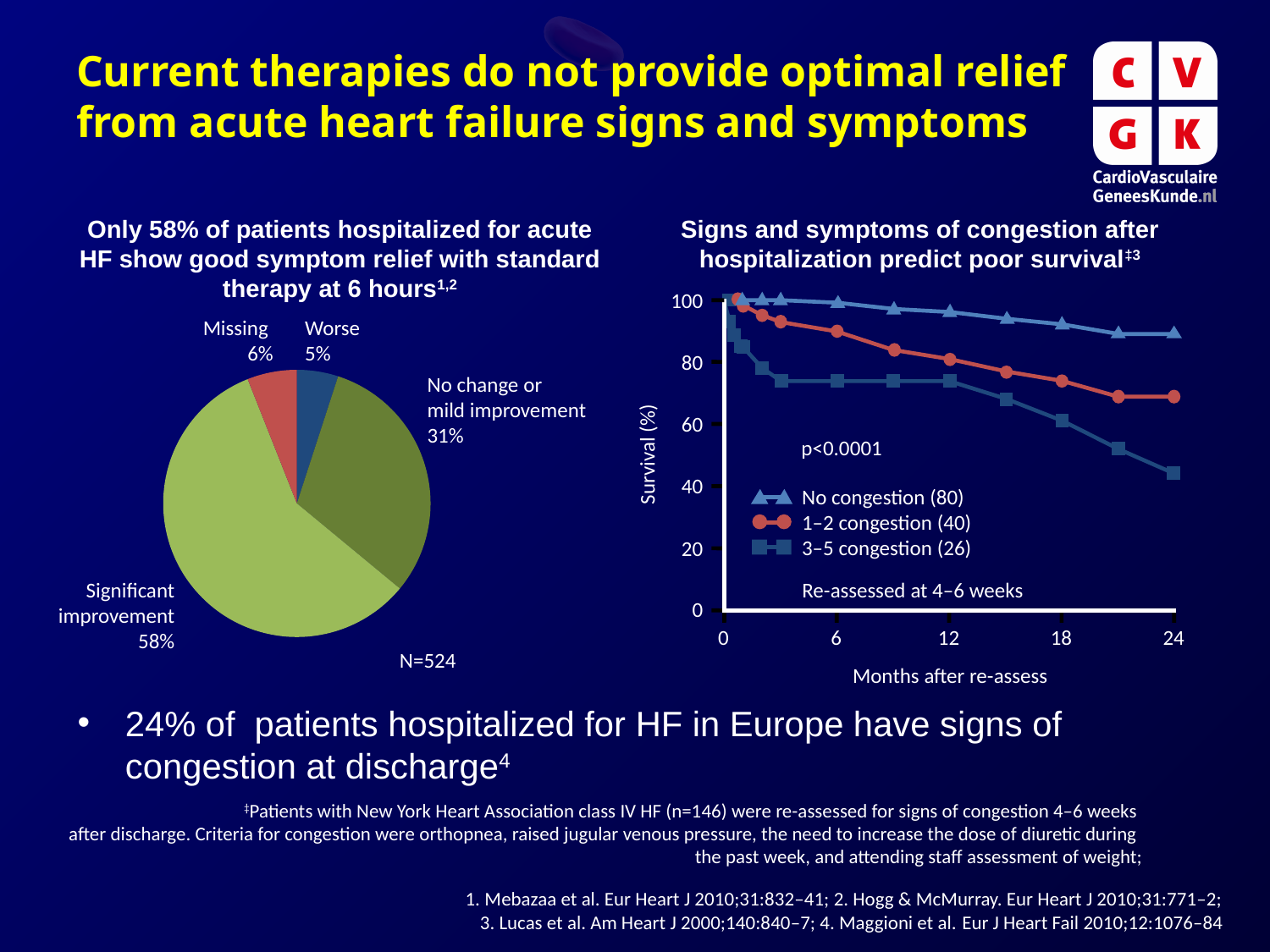
On the pie chart on the left, what is the difference in percentage points between 'Significant improvement' and 'No change or mild improvement'? 27 On the survival chart on the right, is the survival value for the '3–5 congestion (26)' group at 24 months greater or less than 60? less On the pie chart on the left, what share of patients showed significant improvement? 58% On the pie chart on the left, what share of patients showed no change or mild improvement? 31% On the survival chart on the right, how many series does the legend list? 3 What type of chart is the chart on the right showing survival over months? Line chart On the survival chart on the right, is the survival value for the 'No congestion (80)' group at 24 months greater or less than 80? greater On the survival chart on the right, does survival for the '3–5 congestion (26)' group rise or fall as months increase? Fall On the pie chart on the left, which category has the smallest share? Worse On the pie chart on the left, what is the sample size (N) shown? N=524 On the pie chart on the left, how many slices are there? 4 On the pie chart on the left, which category has the largest share? Significant improvement